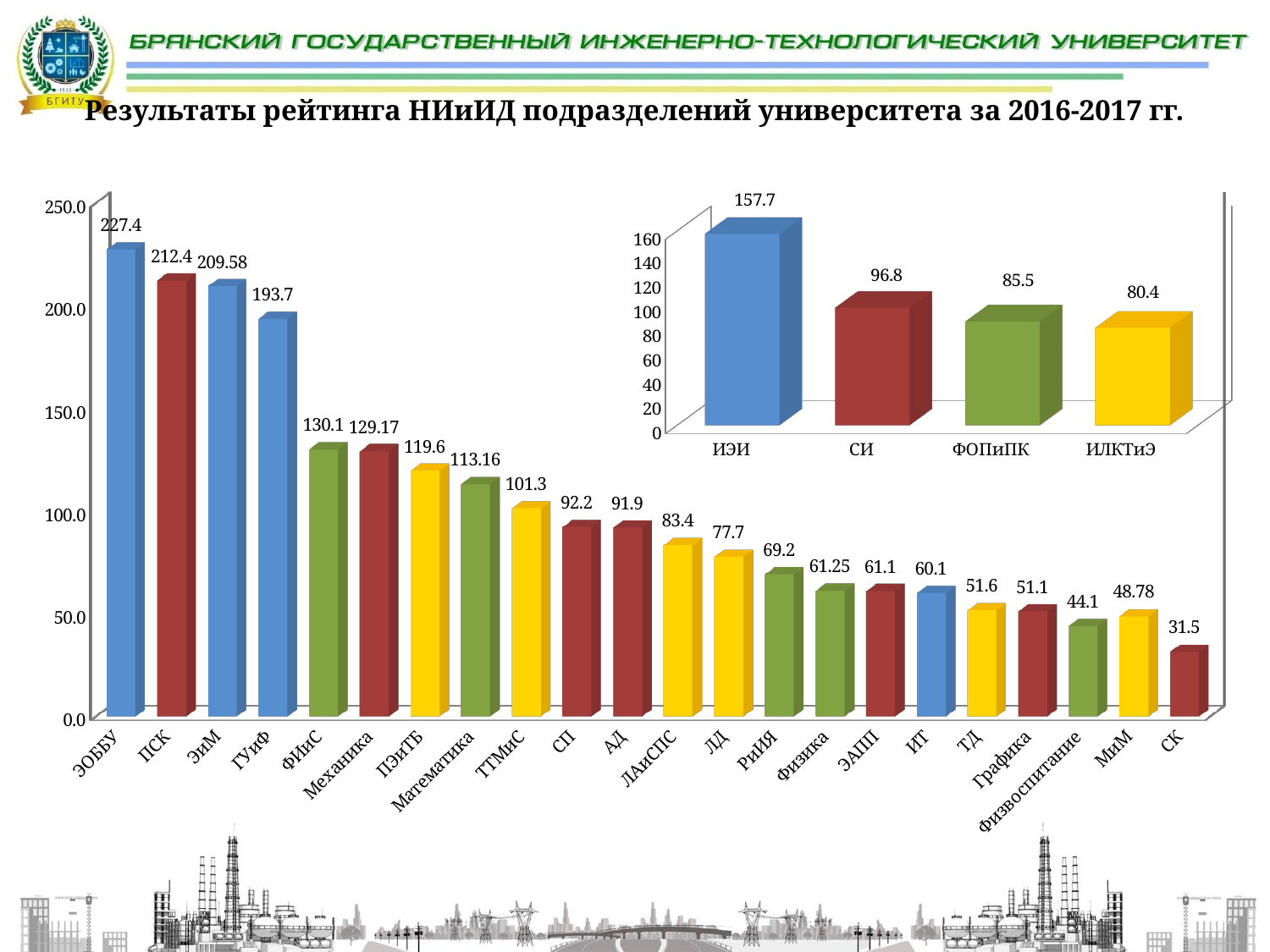
On the large chart, what is the value for Математика? 113.16 On the large chart, how many categories are shown? 22 On the large chart, which category has the highest value? ЭОББУ On the small inset chart in the upper right, which category has the lowest value? ИЛКТиЭ On the large chart, which category has the lowest value? СК What type of chart is the large chart on the slide? Bar chart On the small inset chart in the upper right, what is the difference between the values for СИ and ФОПиПК? 11.3 On the small inset chart in the upper right, how many categories are shown? 4 On the large chart, which is larger, the value for ФИиС or the value for Механика? ФИиС On the small inset chart in the upper right, what is the value for ИЭИ? 157.7 On the large chart, what is the difference between the values for ПСК and ГУиФ? 18.7